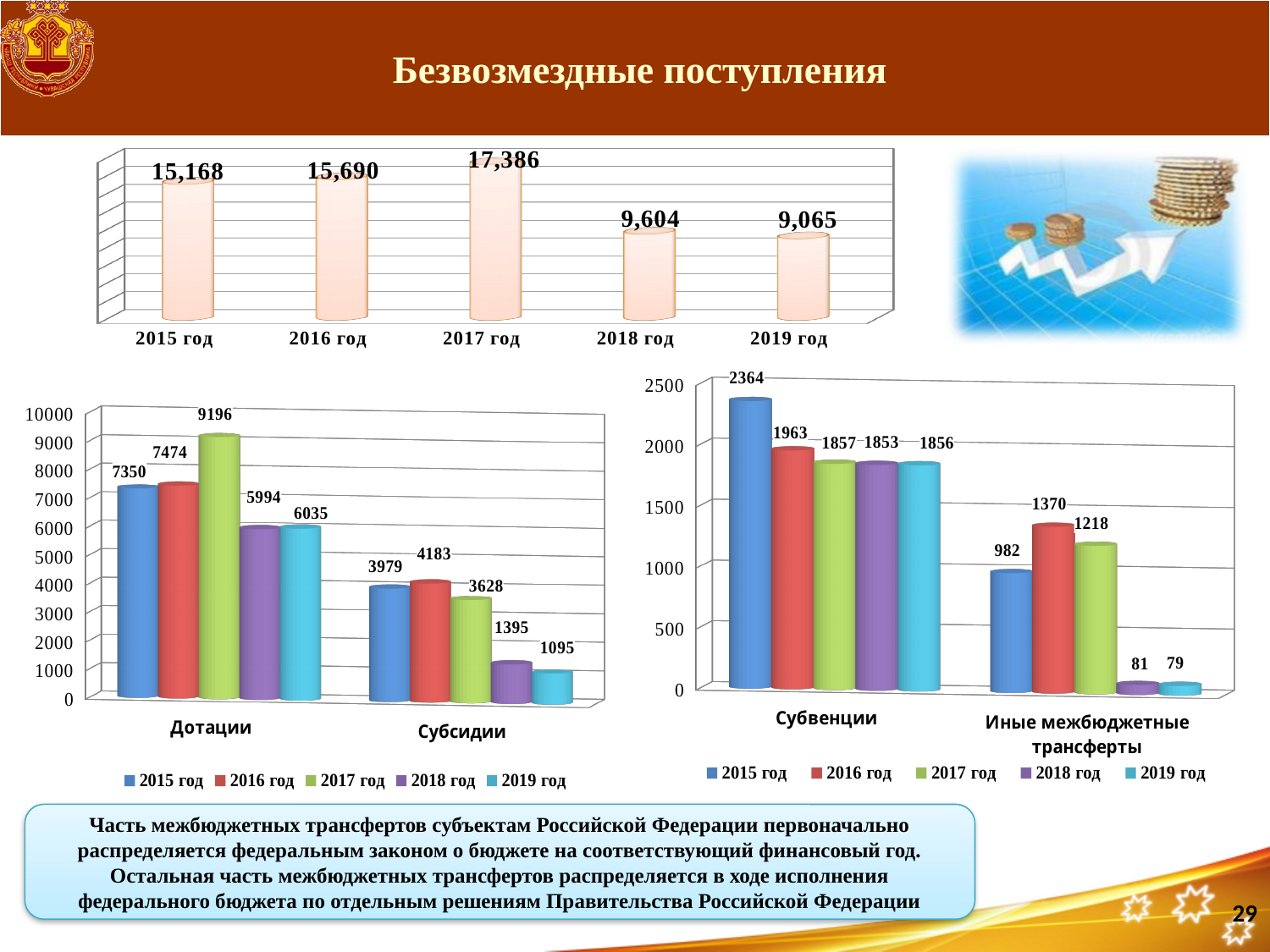
In the top chart, what is the value for 2017 год? 17,386 In the bottom-left chart, which year has the lowest value for Субсидии? 2019 год In the bottom-right chart, what is the value for Субвенции in 2015 год? 2364 What kind of chart is the bottom-right chart? bar chart In the bottom-right chart, is the value for Субвенции in 2016 год larger or smaller than the value for Иные межбюджетные трансферты in 2016 год? larger In the bottom-left chart, what is the value for Дотации in 2017 год? 9196 In the bottom-left chart, what is the difference between the 2016 год and 2015 год values for Субсидии? 204 In the top chart, what is the difference between the values for 2017 год and 2018 год? 7,782 In the top chart, which year has the lowest value? 2019 год In the bottom-left chart, how many series does the legend list? 5 In the top chart, how many bars are plotted? 5 In the bottom-right chart, which year has the highest value for Иные межбюджетные трансферты? 2016 год